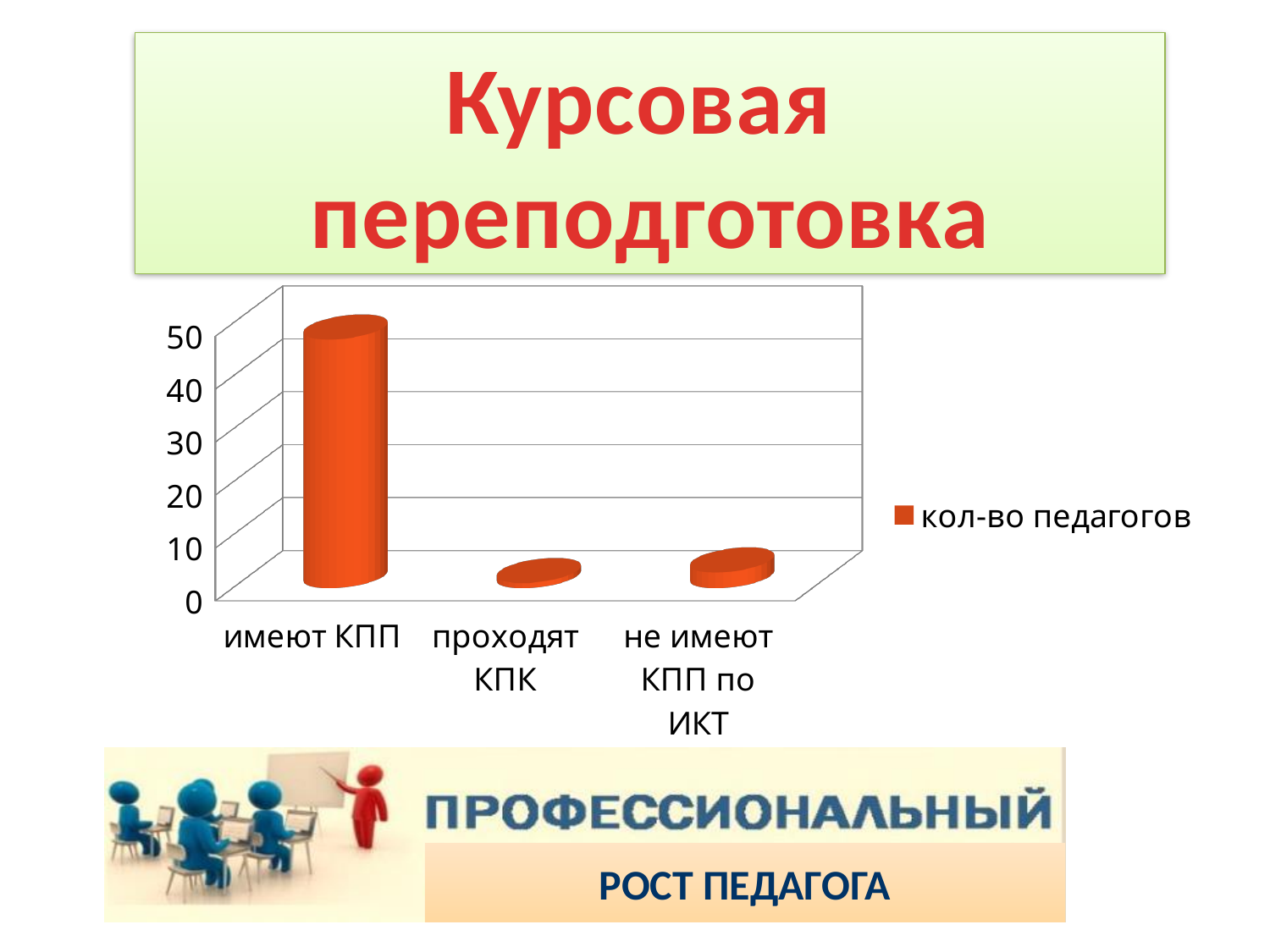
Is the value for "проходят КПК" greater or less than 10? less How many series does the chart's legend list? 1 What kind of chart is shown on the slide? bar chart What is the name of the series listed in the chart's legend? кол-во педагогов Is the value for "имеют КПП" greater or less than 40? greater Which category has the highest value in the chart? имеют КПП Which is larger: the value for "имеют КПП" or the value for "не имеют КПП по ИКТ"? имеют КПП Which is larger: the value for "имеют КПП" or the value for "проходят КПК"? имеют КПП Is the value for "не имеют КПП по ИКТ" greater or less than 10? less How many categories are shown on the x axis of the chart? 3 What is the highest value shown on the chart's vertical axis? 50